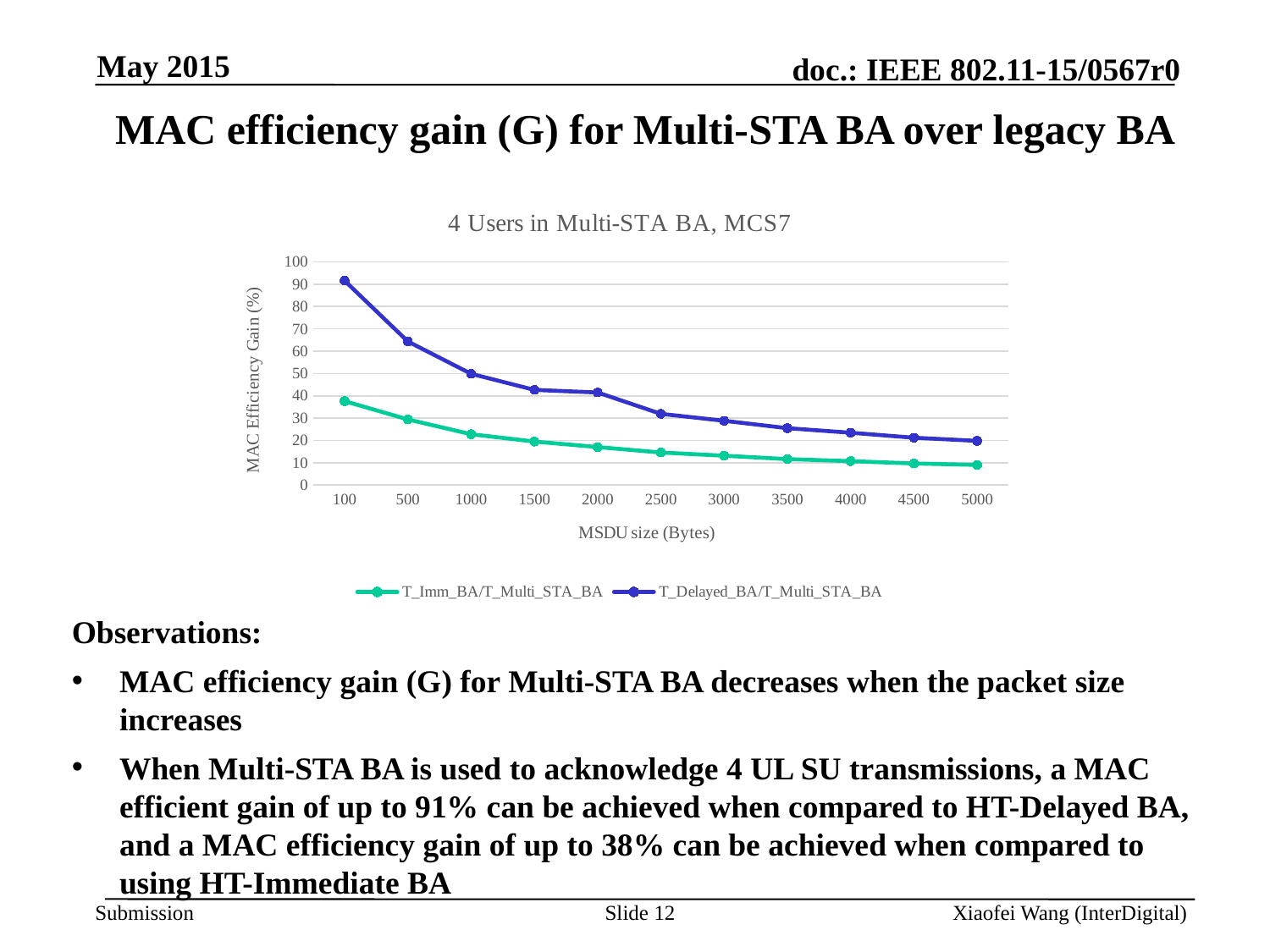
Is the value for T_Delayed_BA/T_Multi_STA_BA at MSDU size 500 greater or less than 60? greater What is the title of the chart? 4 Users in Multi-STA BA, MCS7 At which MSDU size is the T_Imm_BA/T_Multi_STA_BA value lowest? 5000 Do the values of the T_Delayed_BA/T_Multi_STA_BA series rise or fall as MSDU size increases? fall What is the label of the y axis? MAC Efficiency Gain (%) How many MSDU size points are plotted along the x axis? 11 At which MSDU size is the T_Delayed_BA/T_Multi_STA_BA value highest? 100 Is the value for T_Imm_BA/T_Multi_STA_BA at MSDU size 100 greater or less than 40? less At an MSDU size of 2000, which series has the larger value, T_Imm_BA/T_Multi_STA_BA or T_Delayed_BA/T_Multi_STA_BA? T_Delayed_BA/T_Multi_STA_BA What kind of chart is shown on the slide? line chart Is the value for T_Delayed_BA/T_Multi_STA_BA at MSDU size 100 greater or less than 80? greater How many series does the legend list? 2